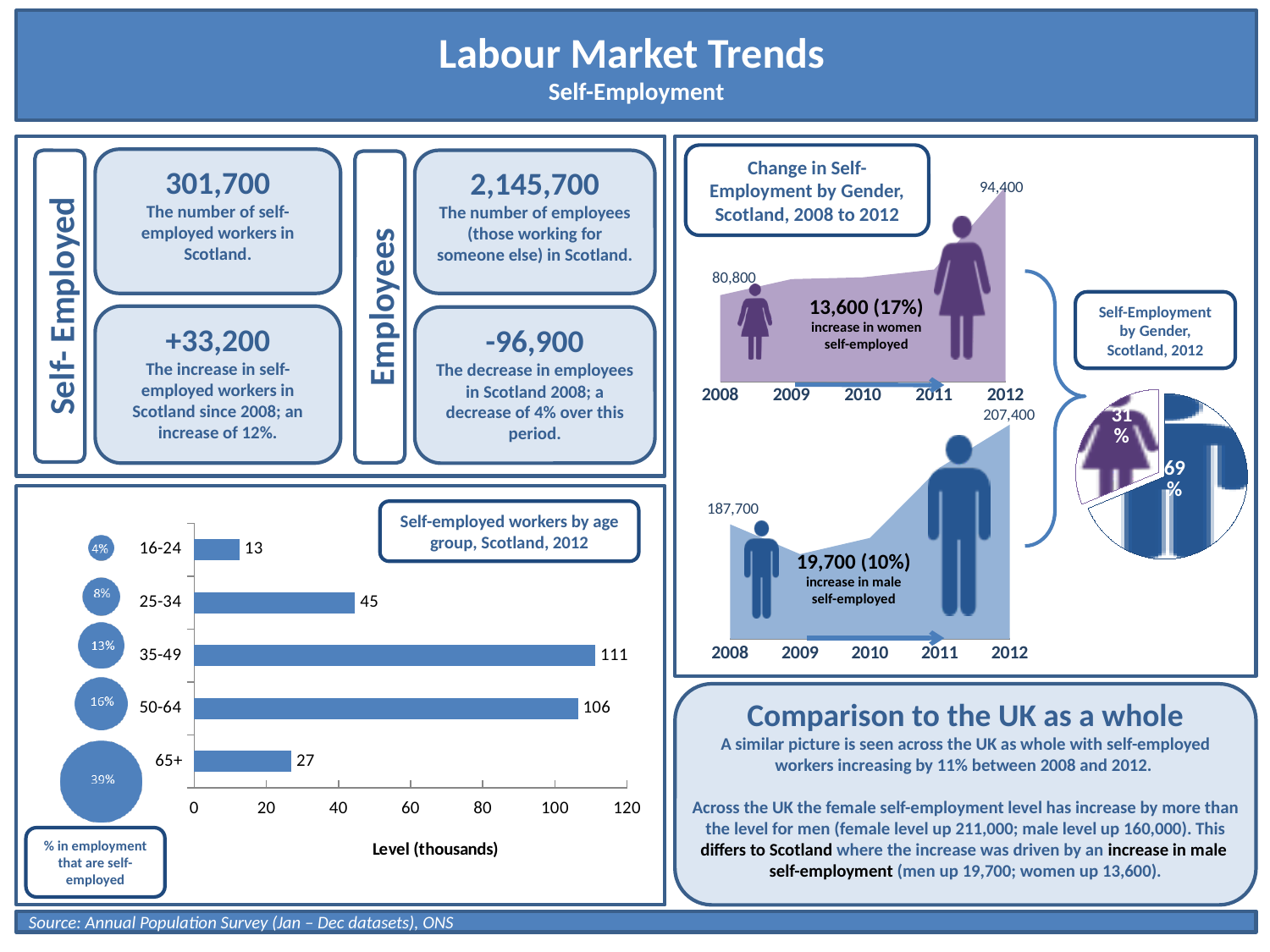
In the 'Change in Self-Employment by Gender, Scotland, 2008 to 2012' chart, what was the number of self-employed women in 2012? 94,400 In the 'Self-Employment by Gender, Scotland, 2012' pie chart, what share of self-employed workers are men? 69% What is the x-axis title of the 'Self-employed workers by age group, Scotland, 2012' chart? Level (thousands) In the 'Change in Self-Employment by Gender, Scotland, 2008 to 2012' chart, what was the number of self-employed men in 2008? 187,700 In the 'Self-employed workers by age group, Scotland, 2012' chart, what is the difference between the values for 35-49 and 50-64? 5 How many age groups are shown in the 'Self-employed workers by age group, Scotland, 2012' chart? 5 In the 'Self-employed workers by age group, Scotland, 2012' chart, what is the value for the 35-49 age group? 111 In the 'Self-employed workers by age group, Scotland, 2012' chart, what is the value for the 65+ age group? 27 In the 'Self-employed workers by age group, Scotland, 2012' chart, which is larger, the value for 25-34 or the value for 65+? 25-34 What kind of chart is 'Self-employed workers by age group, Scotland, 2012'? Bar chart In the 'Self-employed workers by age group, Scotland, 2012' chart, which age group has the lowest value? 16-24 In the 'Self-employed workers by age group, Scotland, 2012' chart, which age group has the highest value? 35-49